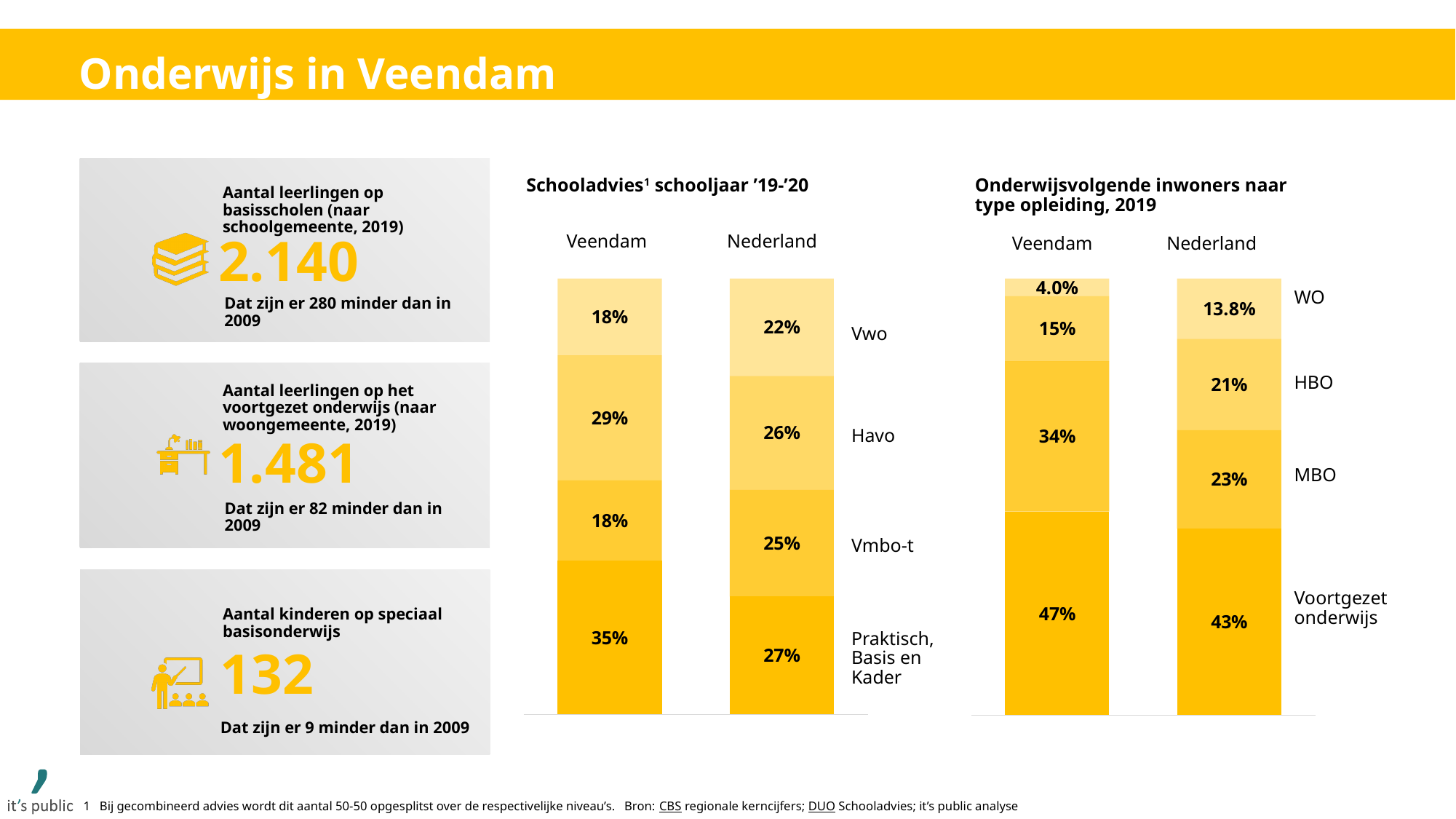
In the 'Onderwijsvolgende inwoners naar type opleiding, 2019' chart, what is the HBO share for Nederland? 21% In the 'Schooladvies schooljaar '19-'20' chart, what is the Havo share for Nederland? 26% In the 'Schooladvies schooljaar '19-'20' chart, what is the Vwo share for Veendam? 18% In the 'Schooladvies schooljaar '19-'20' chart, what is the difference between the Praktisch, Basis en Kader share for Veendam and for Nederland? 8 percentage points In the 'Schooladvies schooljaar '19-'20' chart, which has the larger Vmbo-t share, Veendam or Nederland? Nederland In the 'Schooladvies schooljaar '19-'20' chart, which segment is the largest in the Veendam bar? Praktisch, Basis en Kader In the 'Onderwijsvolgende inwoners naar type opleiding, 2019' chart, which segment is the smallest in the Nederland bar? WO In the 'Onderwijsvolgende inwoners naar type opleiding, 2019' chart, what is the WO share for Veendam? 4.0% In the 'Onderwijsvolgende inwoners naar type opleiding, 2019' chart, which has the larger Voortgezet onderwijs share, Veendam or Nederland? Veendam How many segments does each bar in the 'Schooladvies schooljaar '19-'20' chart have? 4 What kind of chart is the 'Onderwijsvolgende inwoners naar type opleiding, 2019' chart? Stacked bar chart In the 'Onderwijsvolgende inwoners naar type opleiding, 2019' chart, what is the difference between the MBO share for Veendam and for Nederland? 11 percentage points